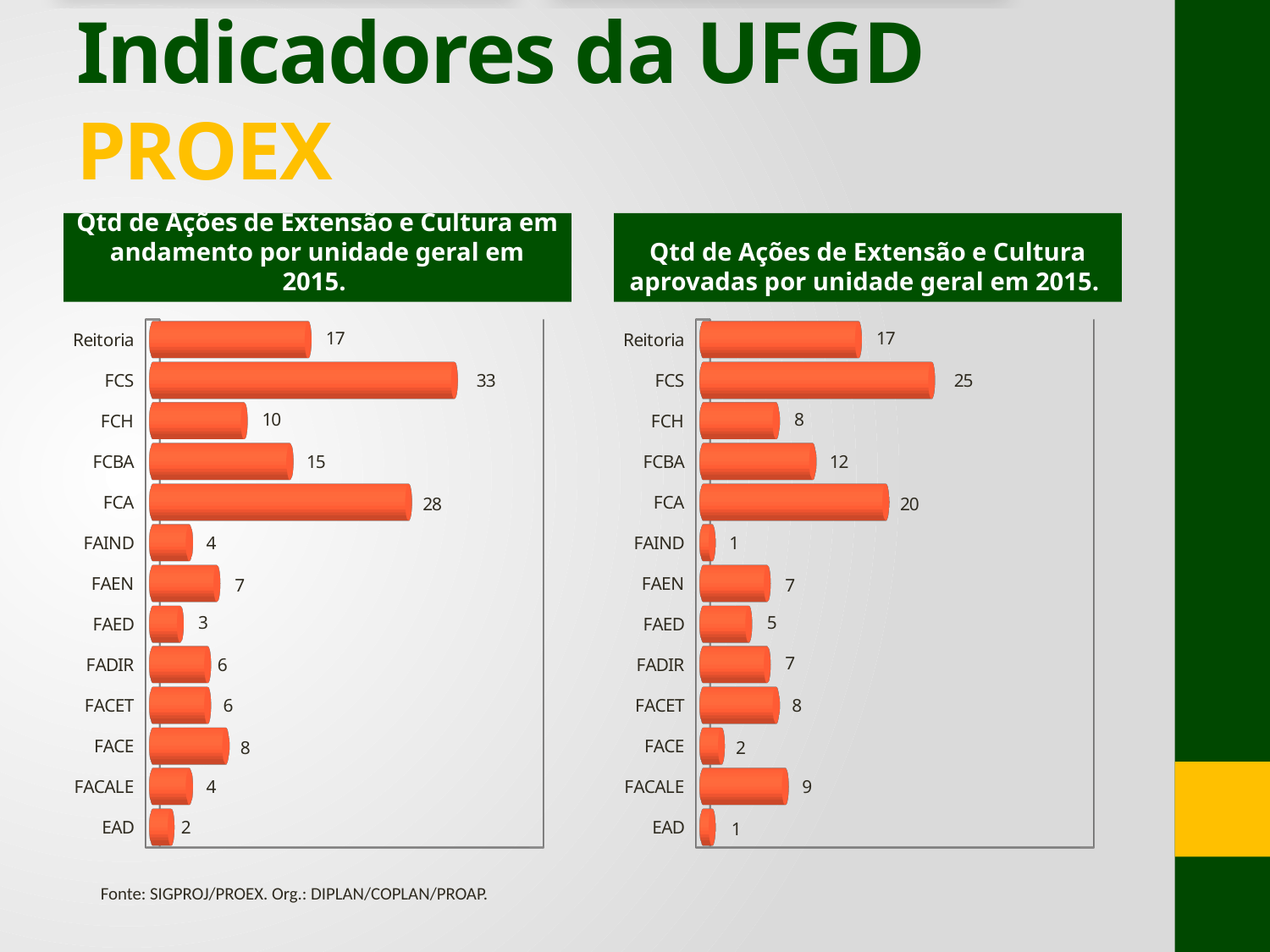
In the right chart (ações aprovadas), which is larger, FACALE or FACET? FACALE In the left chart (ações em andamento), which unit has the lowest value? EAD In the right chart (ações aprovadas), what is the difference between FCS and FCA? 5 In the left chart (ações em andamento), which unit has the highest value? FCS How many units are shown in the right chart (ações aprovadas)? 13 What kind of chart is the left chart (ações em andamento)? Bar chart In the right chart (ações aprovadas), which unit has the highest value? FCS What is the title of the right chart? Qtd de Ações de Extensão e Cultura aprovadas por unidade geral em 2015. In the left chart (ações em andamento), what is the value for FCA? 28 In the right chart (ações aprovadas), what is the value for FCBA? 12 In the left chart (ações em andamento), what is the difference between FCS and Reitoria? 16 In the left chart (ações em andamento), which is larger, FCBA or FCH? FCBA